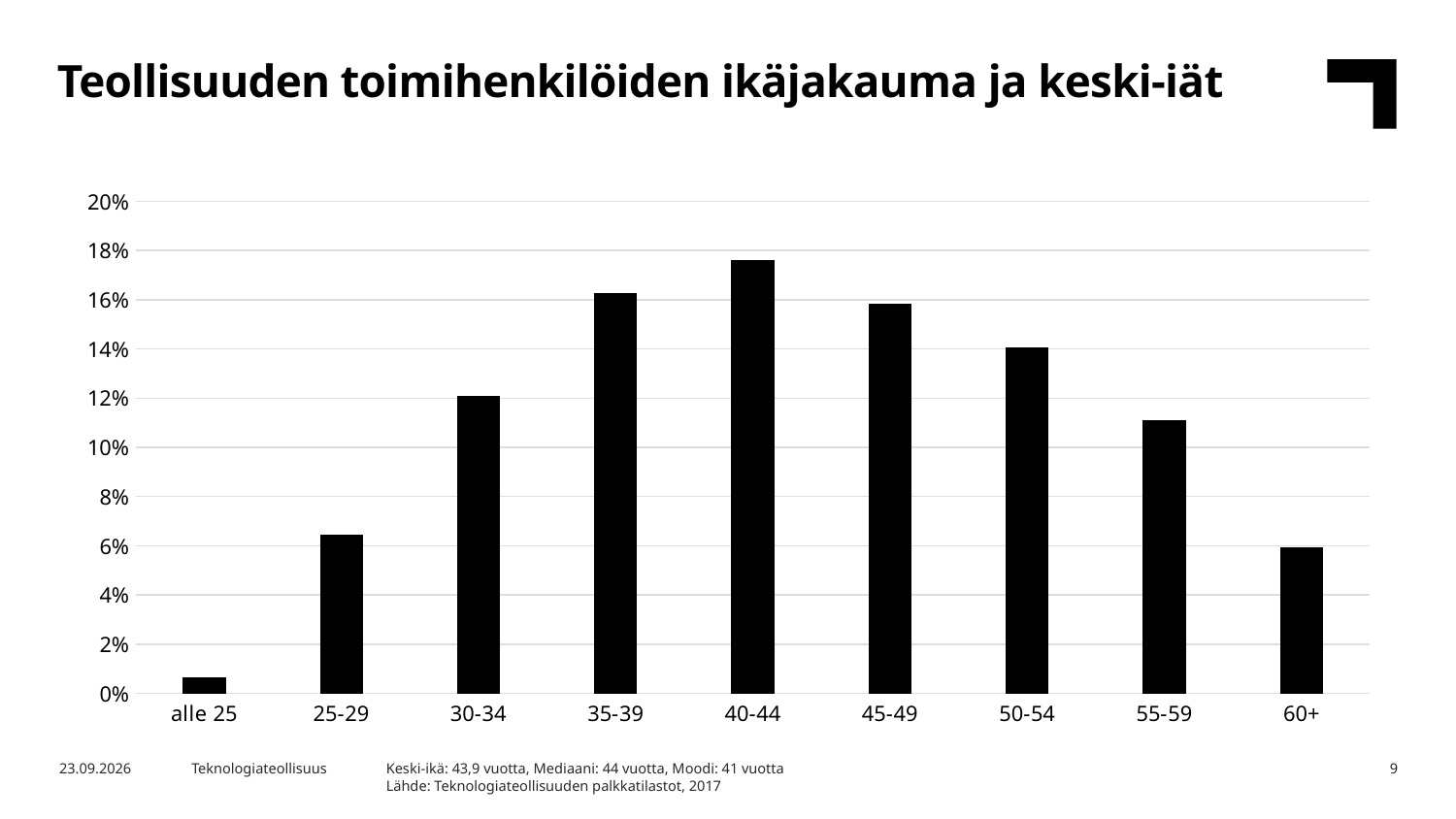
Is the value for 30-34 greater or less than 10%? greater What is the title of the chart on the slide? Teollisuuden toimihenkilöiden ikäjakauma ja keski-iät How do the values change from alle 25 to 40-44 along the x axis? They rise Is the value for 40-44 greater or less than 16%? greater Is the value for 60+ greater or less than 8%? less How many age categories are shown on the x axis? 9 Which has a larger share, 50-54 or 30-34? 50-54 What kind of chart is shown on the slide? Bar chart Which age category has the highest share? 40-44 Which age category has the lowest share? alle 25